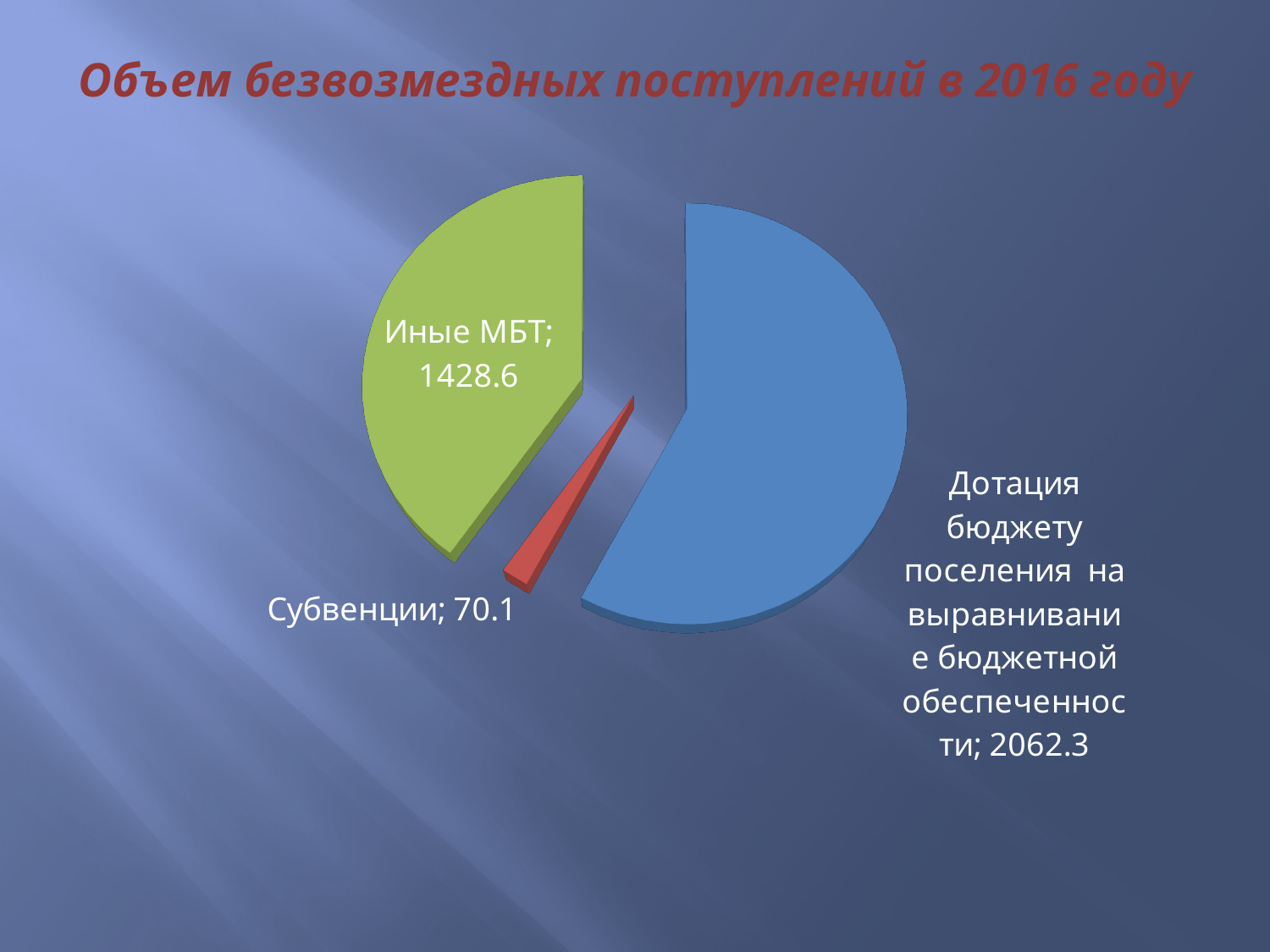
How many slices does the pie chart have? 3 What is the difference between the values for Иные МБТ and Субвенции? 1358.5 What is the value for Субвенции? 70.1 What type of chart is shown on the slide? Pie chart What is the value for Иные МБТ? 1428.6 What is the title of the chart? Объем безвозмездных поступлений в 2016 году Which is larger, Иные МБТ or Субвенции? Иные МБТ Which category has the largest slice of the pie? Дотация бюджету поселения на выравнивание бюджетной обеспеченности Which category has the smallest slice of the pie? Субвенции What is the difference between the values for Дотация бюджету поселения на выравнивание бюджетной обеспеченности and Иные МБТ? 633.7 What is the value for Дотация бюджету поселения на выравнивание бюджетной обеспеченности? 2062.3 What is the total of all slices in the pie chart? 3561.0